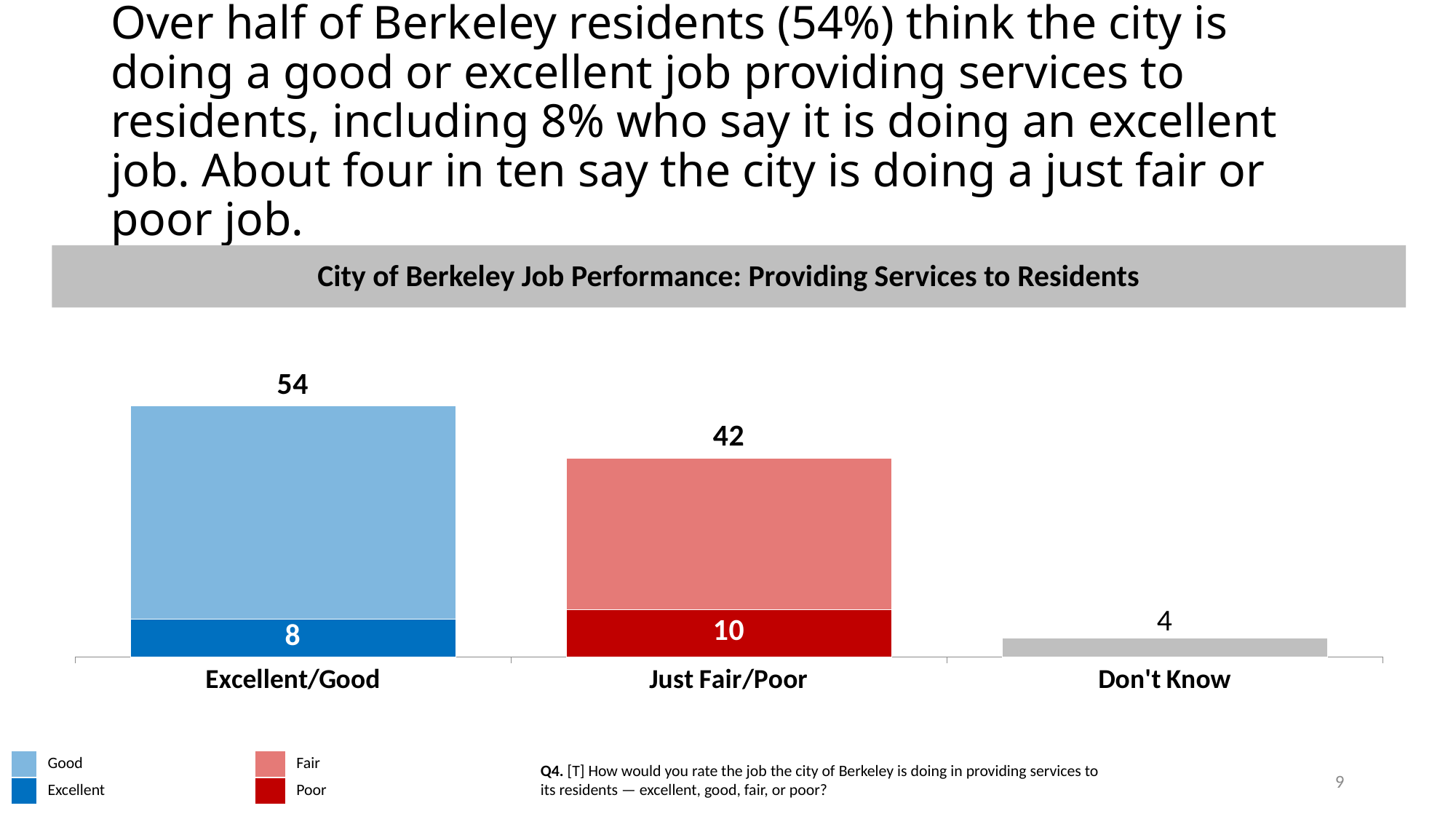
What is the total value shown for the Just Fair/Poor bar? 42 What value is shown for the Excellent segment of the Excellent/Good bar? 8 What value is shown for the Poor segment of the Just Fair/Poor bar? 10 What is the difference between the Excellent/Good total and the Just Fair/Poor total? 12 What is the total value shown for the Excellent/Good bar? 54 How many categories are shown on the x axis? 3 What value is shown for Don't Know? 4 What type of chart is shown on the slide? Stacked bar chart Which category has the lowest value? Don't Know How many entries does the legend list? 4 Which category has the highest total value? Excellent/Good Which is larger, the Poor segment or the Excellent segment? Poor